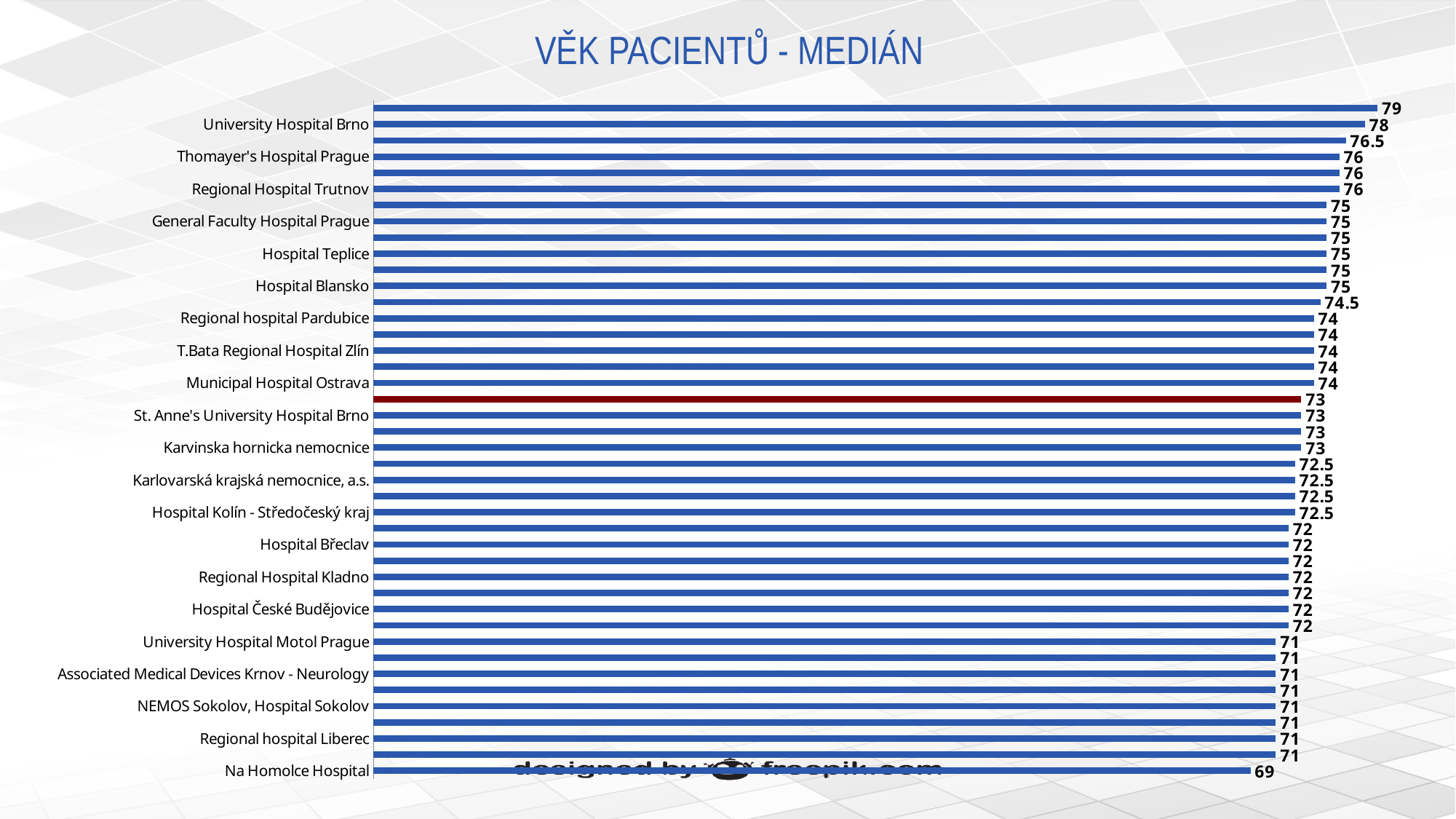
Which has a higher median patient age, General Faculty Hospital Prague or Regional hospital Liberec? General Faculty Hospital Prague What is the median patient age for University Hospital Motol Prague? 71 What kind of chart is shown on the slide? Bar chart What is the median patient age for University Hospital Brno? 78 What is the median patient age for Na Homolce Hospital? 69 What is the median patient age for Karlovarská krajská nemocnice, a.s.? 72.5 What is the difference in median patient age between University Hospital Brno and Na Homolce Hospital? 9 What is the median patient age for Regional hospital Pardubice? 74 Which labelled hospital has the lowest median patient age? Na Homolce Hospital What value is shown on the bar highlighted in dark red? 73 Which has a higher median patient age, St. Anne's University Hospital Brno or Regional Hospital Trutnov? Regional Hospital Trutnov What is the difference in median patient age between Thomayer's Hospital Prague and Hospital Břeclav? 4